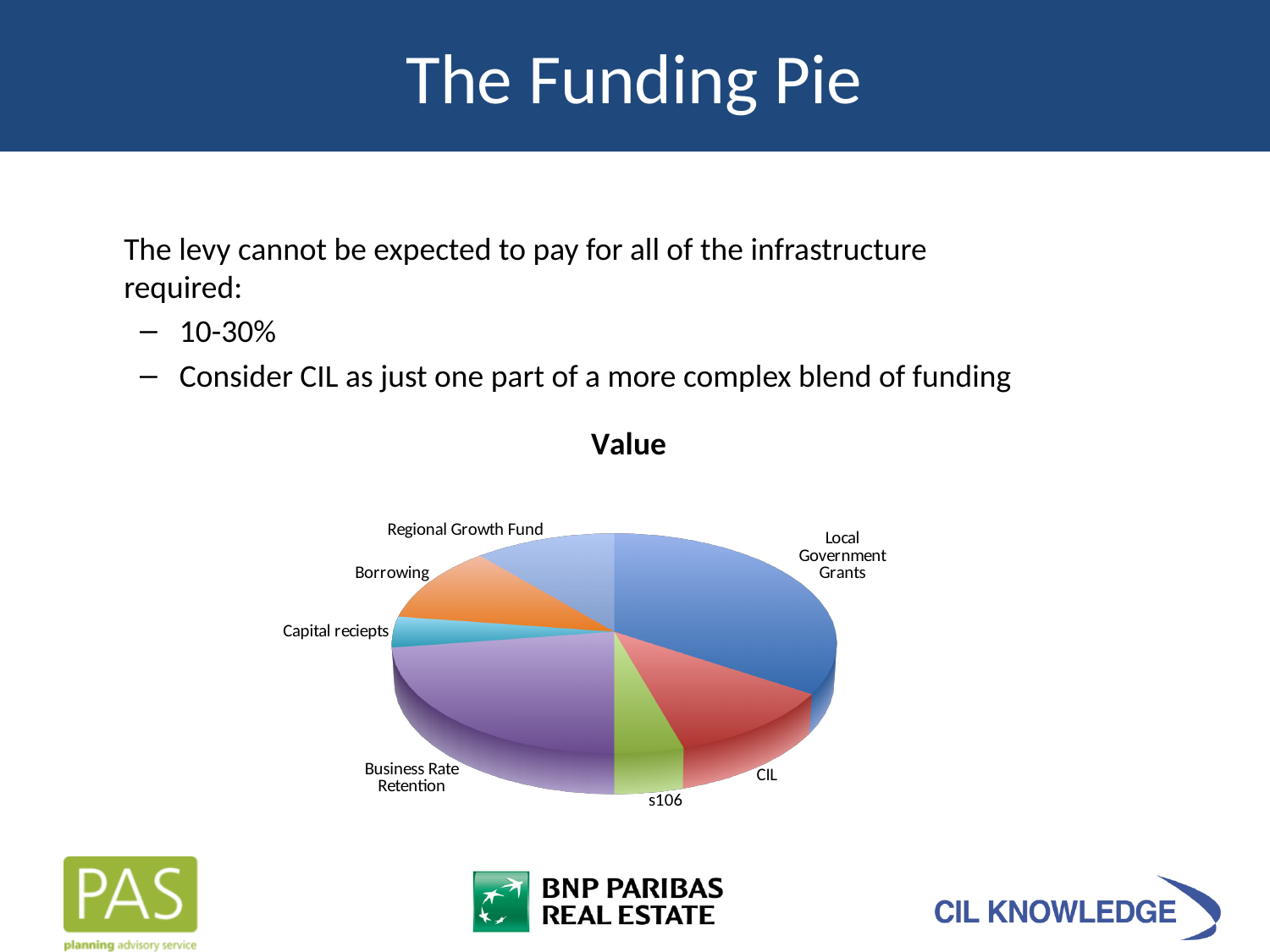
Which category has the largest slice of the pie chart? Local Government Grants What is the title of the pie chart? Value What colour is the Business Rate Retention slice? Purple What kind of chart is shown on the slide? Pie chart Which slice is larger, CIL or s106? CIL How many slices does the pie chart have? 7 Which slice is larger, Borrowing or Capital reciepts? Borrowing Which slice is larger, Local Government Grants or s106? Local Government Grants